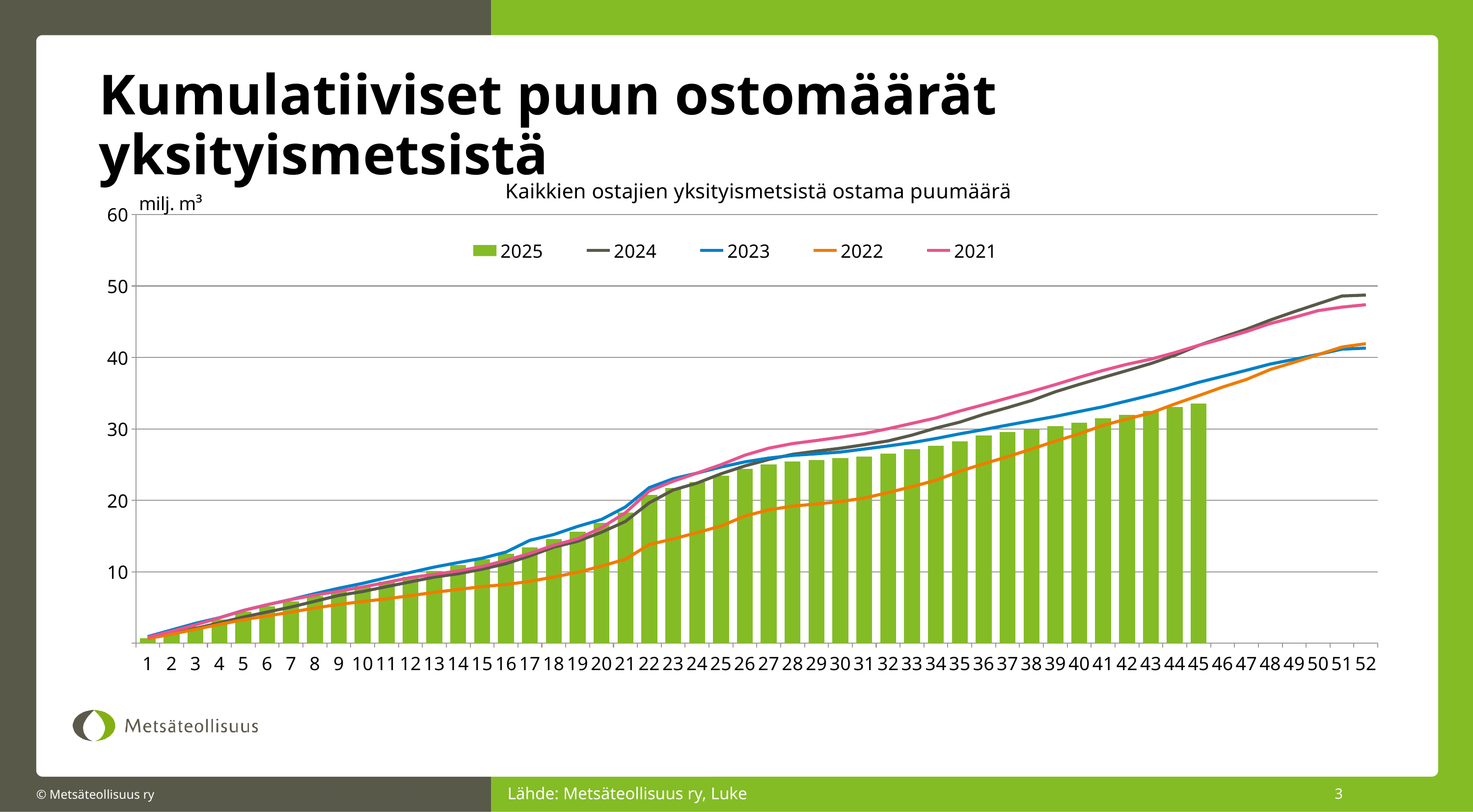
Is the 2025 value at week 45 greater or less than 30? greater Is the 2024 value at week 52 greater or less than 40? greater How many series does the chart legend list? 5 What is the title printed above the chart? Kaikkien ostajien yksityismetsistä ostama puumäärä Which series has the lowest value at week 30? 2022 Do the values of the 2023 series rise or fall as the week number increases? rise Which series has the highest value at week 52? 2024 What kind of chart is shown on the slide? A combined bar and line chart Which series is drawn as bars rather than a line? 2025 Up to which week number do the 2025 bars extend? 45 At week 30, which is larger: the 2021 value or the 2022 value? 2021